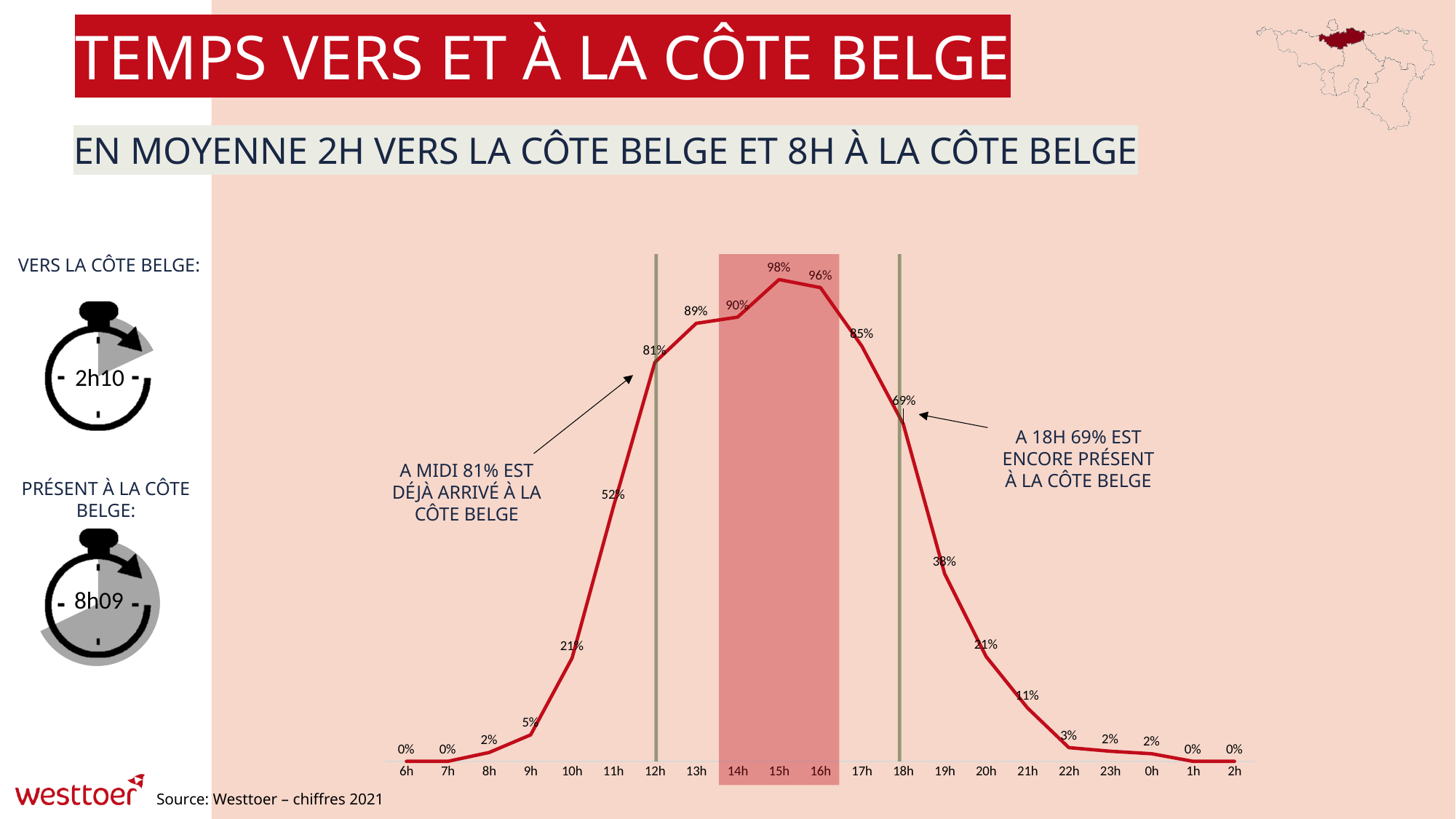
What is the value at 18h? 69% What is the difference between the values at 16h and 17h? 11% Which is larger, the value at 10h or the value at 19h? 19h Which hours are highlighted by the shaded band on the chart? 14h, 15h and 16h How many hourly points are plotted on the x axis? 21 At which hour is the value highest? 15h What kind of chart is shown on the slide? line chart What is the value at 11h? 52% What is the value at 15h? 98% What is the value at 12h? 81% Do the values rise or fall between 6h and 15h? rise What is the difference between the values at 12h and 18h? 12%